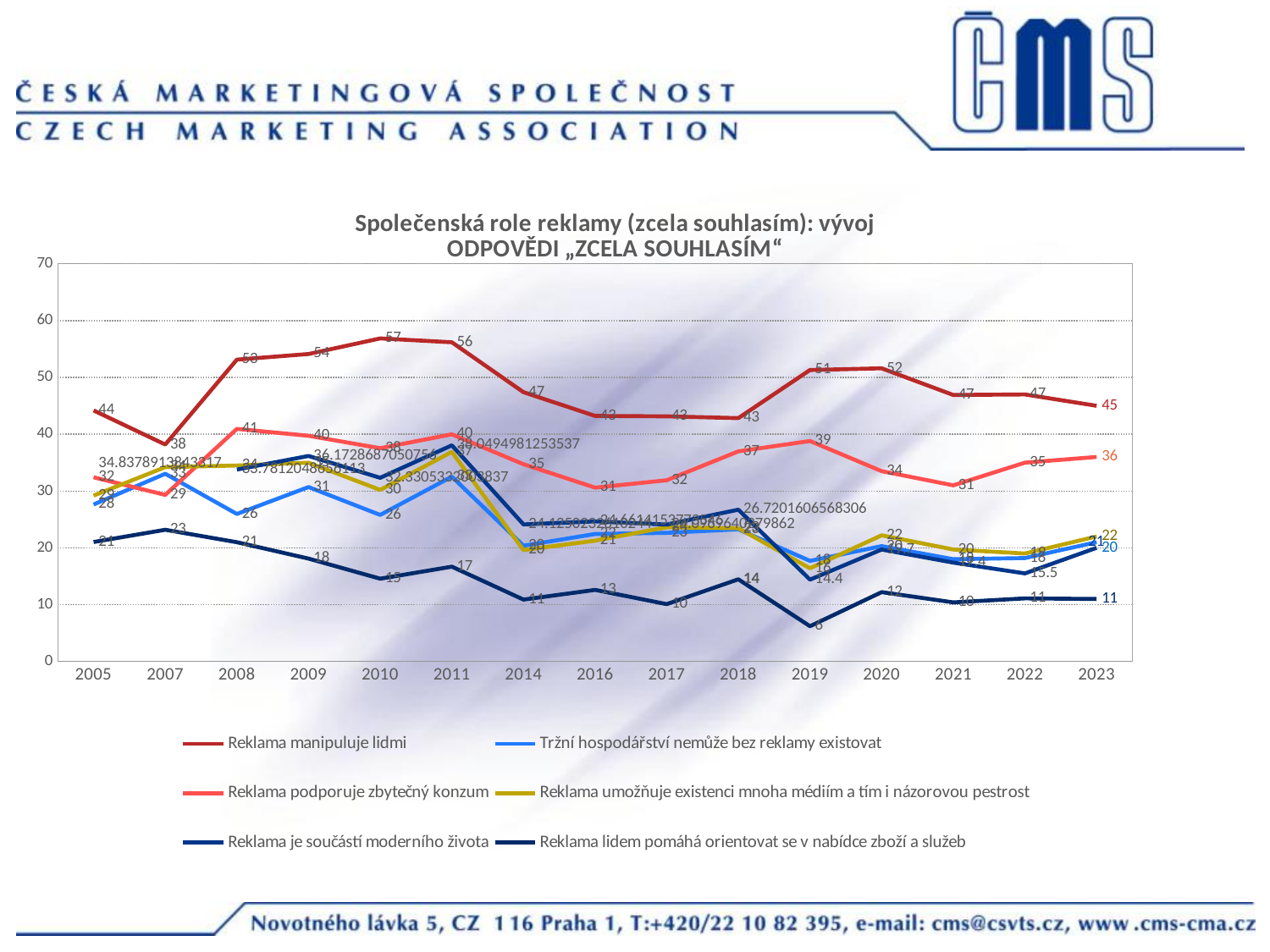
What is the value for 'Reklama manipuluje lidmi' in 2011? 56 How many series does the legend list? 6 In 2023, which is larger: 'Reklama manipuluje lidmi' or 'Reklama podporuje zbytečný konzum'? Reklama manipuluje lidmi In which year does 'Reklama manipuluje lidmi' have its lowest value? 2007 Does the value for 'Reklama manipuluje lidmi' rise or fall from 2020 to 2023? fall Is the value for 'Reklama manipuluje lidmi' in 2005 greater or less than 40? greater In which year does 'Reklama manipuluje lidmi' reach its highest value? 2010 What is the value for 'Reklama manipuluje lidmi' in 2023? 45 What is the value for 'Reklama podporuje zbytečný konzum' in 2023? 36 What type of chart is shown on the slide? line chart How many years are shown on the x axis? 15 What is the difference between the 2010 and 2023 values for 'Reklama manipuluje lidmi'? 12